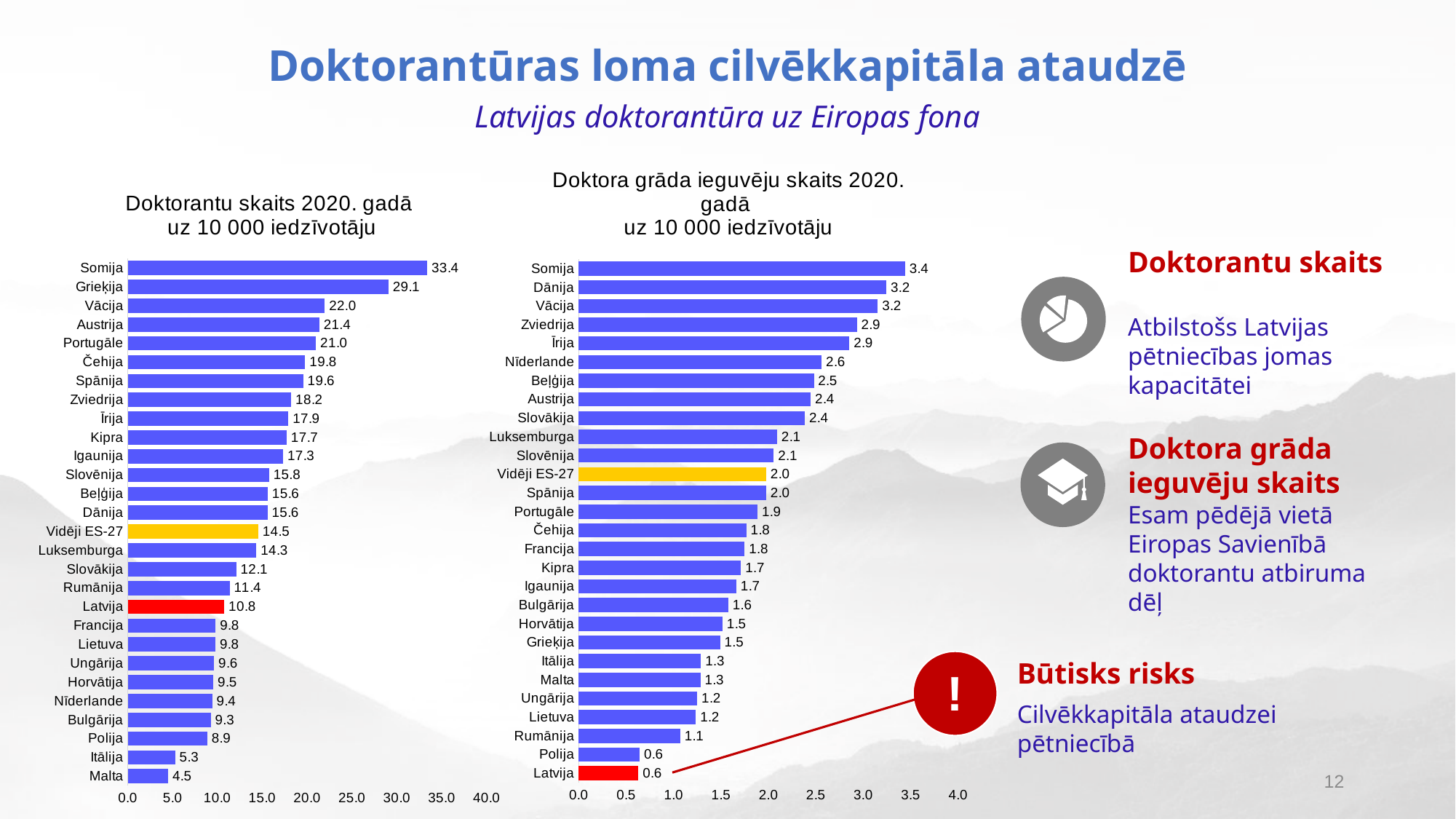
In the right chart (Doktora grāda ieguvēju skaits 2020. gadā), which country has the highest value? Somija In the left chart (Doktorantu skaits 2020. gadā), which country has the highest value? Somija In the right chart (Doktora grāda ieguvēju skaits 2020. gadā), what is the value for Latvija? 0.6 In the left chart (Doktorantu skaits 2020. gadā), what is the difference between Somija and Grieķija? 4.3 In the left chart (Doktorantu skaits 2020. gadā), which country has the lowest value? Malta In the left chart (Doktorantu skaits 2020. gadā), what is the value for Vidēji ES-27? 14.5 In the left chart (Doktorantu skaits 2020. gadā), how many bars are shown? 28 What type of chart is the left chart (Doktorantu skaits 2020. gadā)? Bar chart In the right chart (Doktora grāda ieguvēju skaits 2020. gadā), what is the difference between Vidēji ES-27 and Latvija? 1.4 In the right chart (Doktora grāda ieguvēju skaits 2020. gadā), which is larger, the value for Dānija or the value for Zviedrija? Dānija In the left chart (Doktorantu skaits 2020. gadā), what is the value for Latvija? 10.8 In the left chart (Doktorantu skaits 2020. gadā), what colour is the bar for Latvija? Red